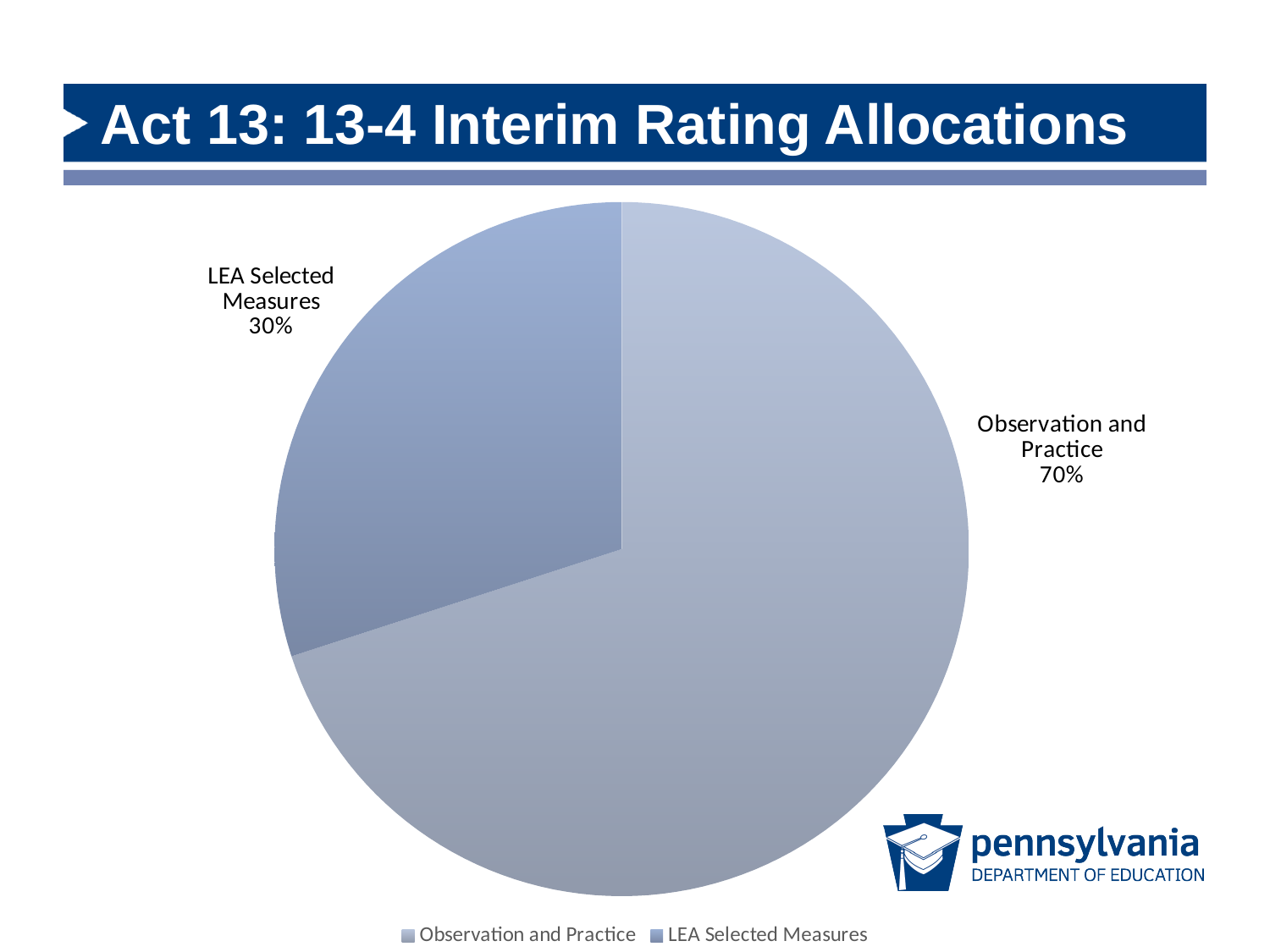
What share of the pie does Observation and Practice represent? 70% How many slices does the pie chart have? 2 How many entries does the legend list? 2 Which slice is the largest? Observation and Practice What kind of chart is shown on the slide? pie chart What is the difference in percentage points between Observation and Practice and LEA Selected Measures? 40 Which is larger, Observation and Practice or LEA Selected Measures? Observation and Practice What is the title of the slide containing the chart? Act 13: 13-4 Interim Rating Allocations Where is the legend positioned relative to the pie chart? below the chart Which slice is the smallest? LEA Selected Measures What share of the pie does LEA Selected Measures represent? 30%